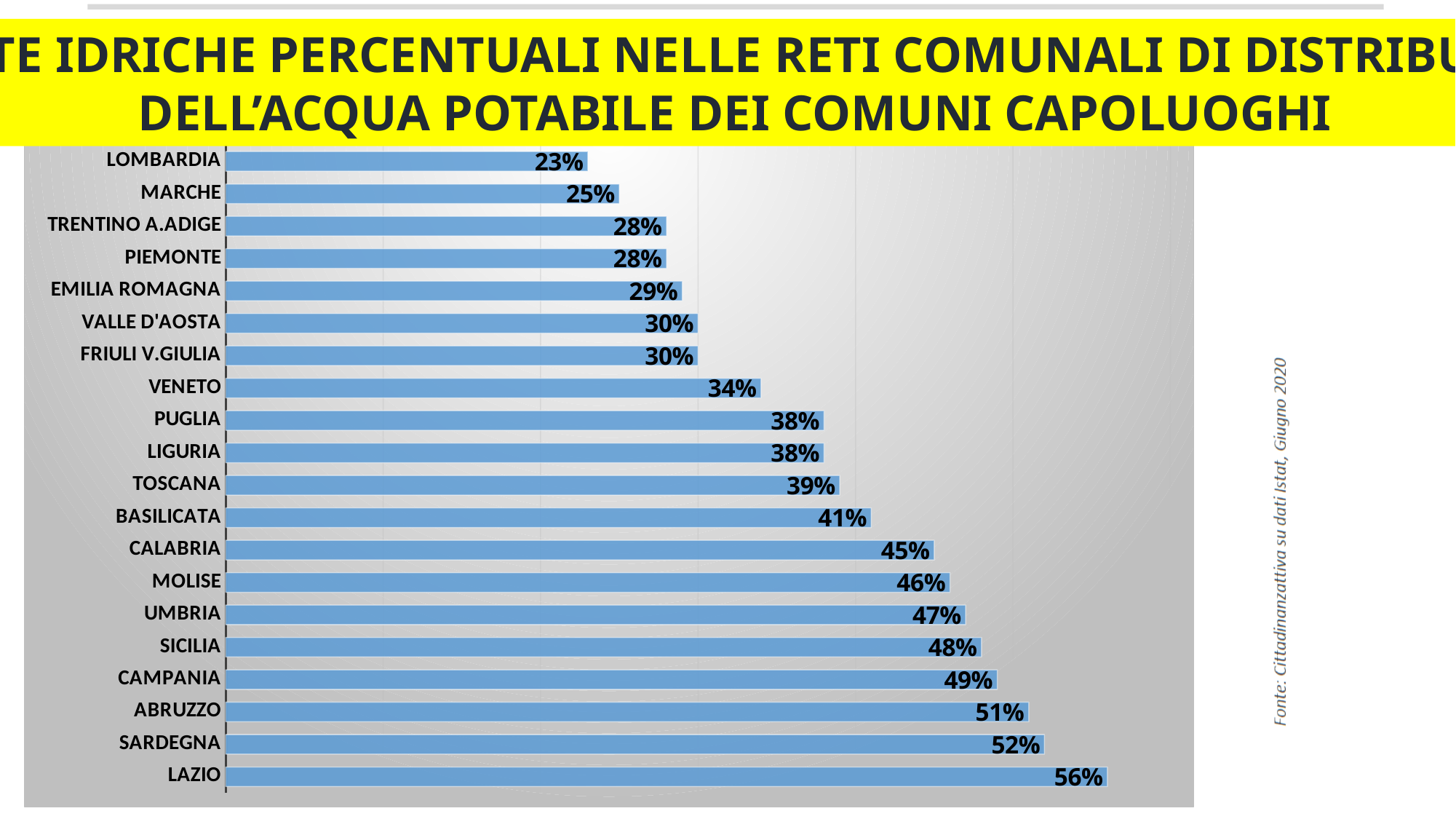
What is the difference between the values for SARDEGNA and TOSCANA? 13% What kind of chart is shown on the slide? Bar chart What is the value for CALABRIA? 45% What source is cited for the chart data? Cittadinanzattiva su dati Istat, Giugno 2020 What is the value for VENETO? 34% Which region has the highest value? LAZIO What is the difference between the values for LAZIO and LOMBARDIA? 33% What is the value for LAZIO? 56% How many regions are shown in the chart? 20 Which region has the lowest value? LOMBARDIA Which has a larger value, PUGLIA or CAMPANIA? CAMPANIA Which has a larger value, UMBRIA or MARCHE? UMBRIA